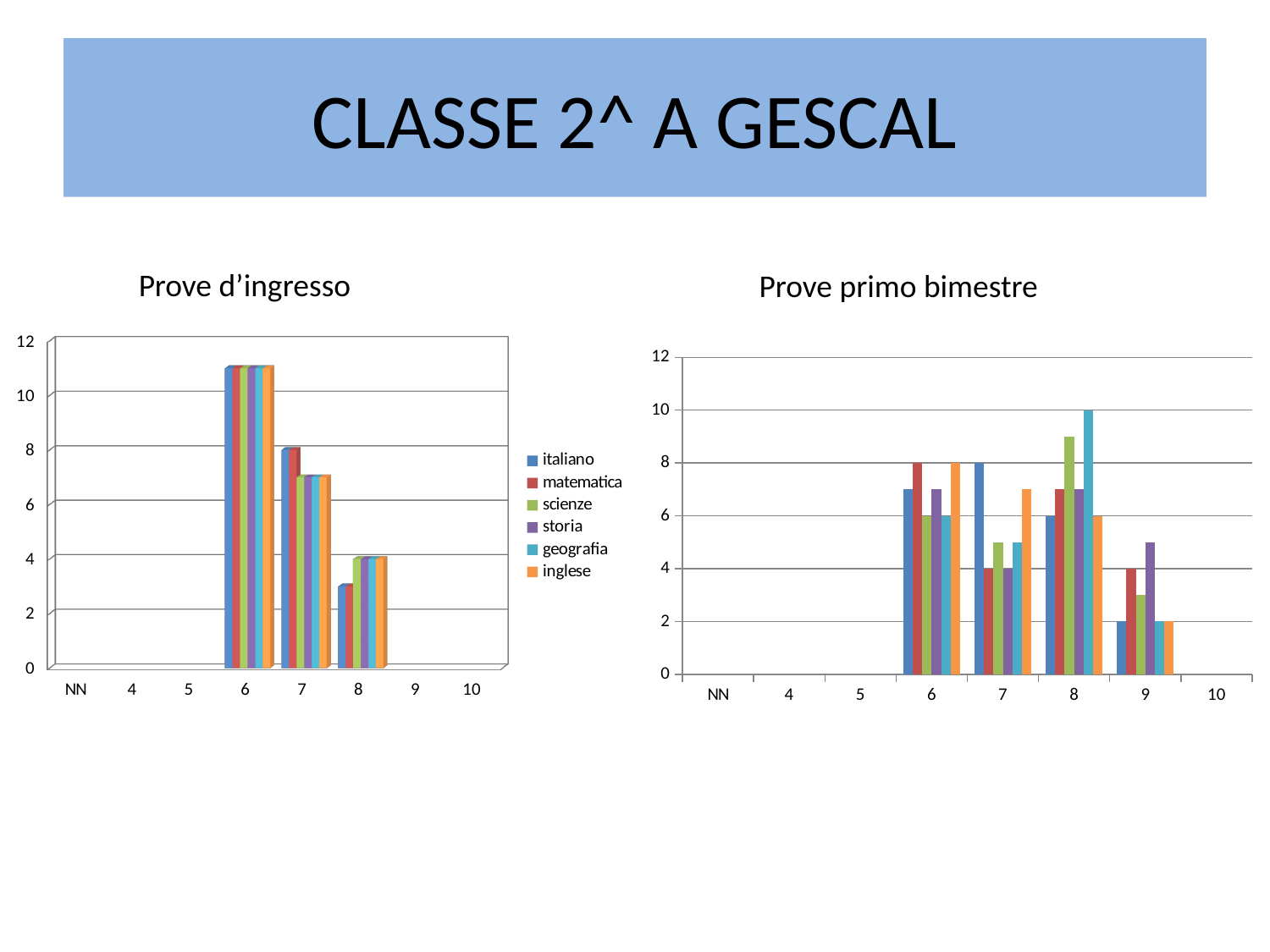
In the "Prove d'ingresso" chart, is the value for italiano at category 8 larger or smaller than the value for scienze at category 8? smaller In the "Prove primo bimestre" chart, what is the value for geografia at category 8? 10 What kind of chart is the "Prove primo bimestre" chart? bar chart In the "Prove primo bimestre" chart, is the value for scienze at category 8 greater or less than 8? greater In the "Prove primo bimestre" chart, what is the value for matematica at category 9? 4 What is the title of the chart on the left of the slide? Prove d'ingresso In the "Prove d'ingresso" chart, is the value for italiano at category 6 greater or less than 10? greater In the "Prove primo bimestre" chart, what is the value for italiano at category 7? 8 In the "Prove primo bimestre" chart, which series has the tallest bar at category 8? geografia How many categories are shown on the x axis of the "Prove primo bimestre" chart? 8 How many series does the legend of the "Prove d'ingresso" chart list? 6 In the "Prove d'ingresso" chart, which category has the tallest bars? 6